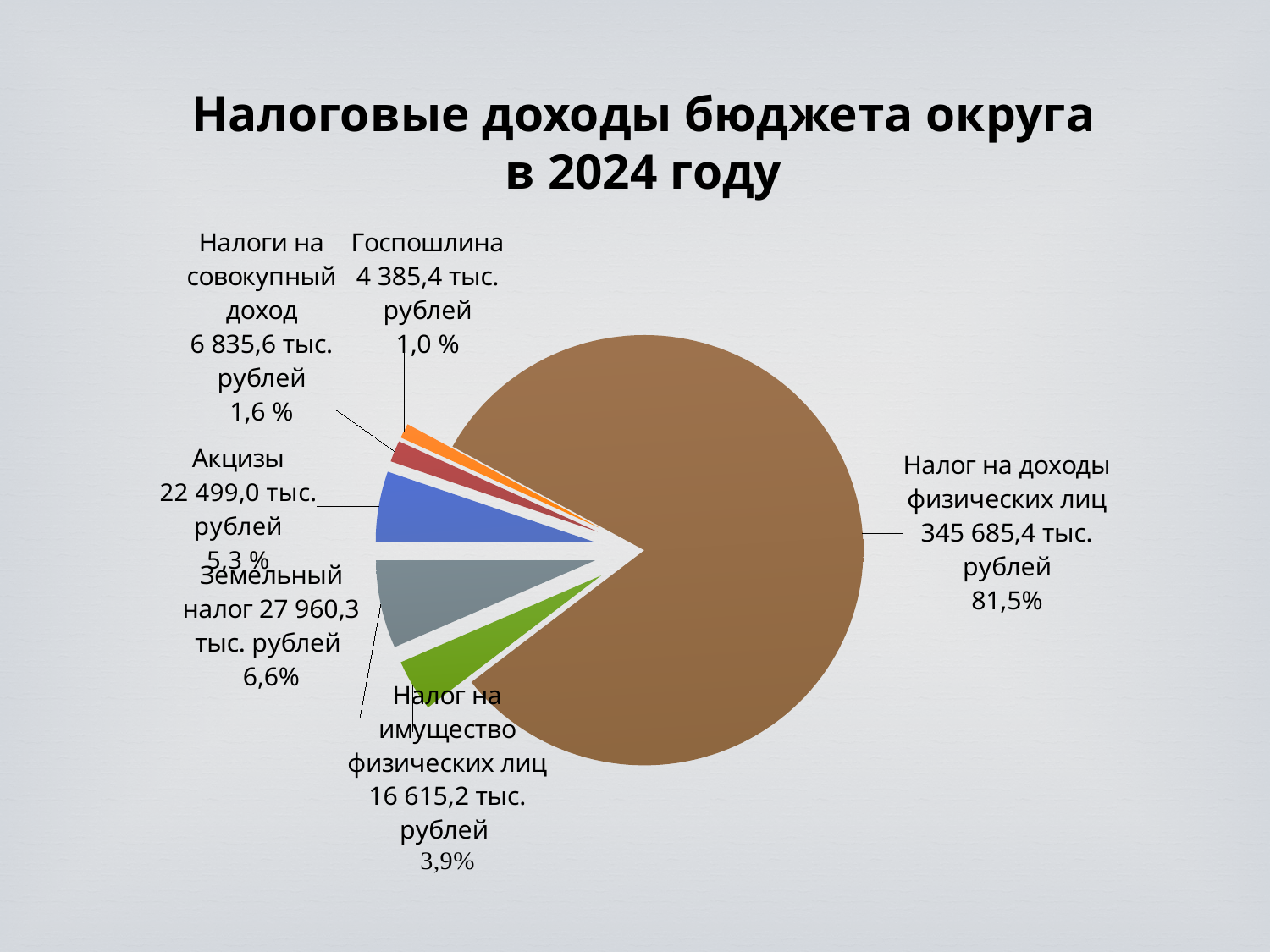
Какова сумма земельного налога? 27 960,3 тыс. рублей Как называется диаграмма на слайде? Налоговые доходы бюджета округа в 2024 году Что больше: земельный налог или акцизы? Земельный налог Сколько категорий показано на круговой диаграмме? 6 Какова сумма госпошлины? 4 385,4 тыс. рублей Какой источник налоговых доходов является наибольшим? Налог на доходы физических лиц Какой тип диаграммы показан на слайде? Круговая диаграмма Какова сумма налога на доходы физических лиц? 345 685,4 тыс. рублей Какова сумма акцизов? 22 499,0 тыс. рублей Какую долю составляют налоги на совокупный доход? 1,6 % Какой источник налоговых доходов является наименьшим? Госпошлина Какую долю составляет налог на имущество физических лиц? 3,9%